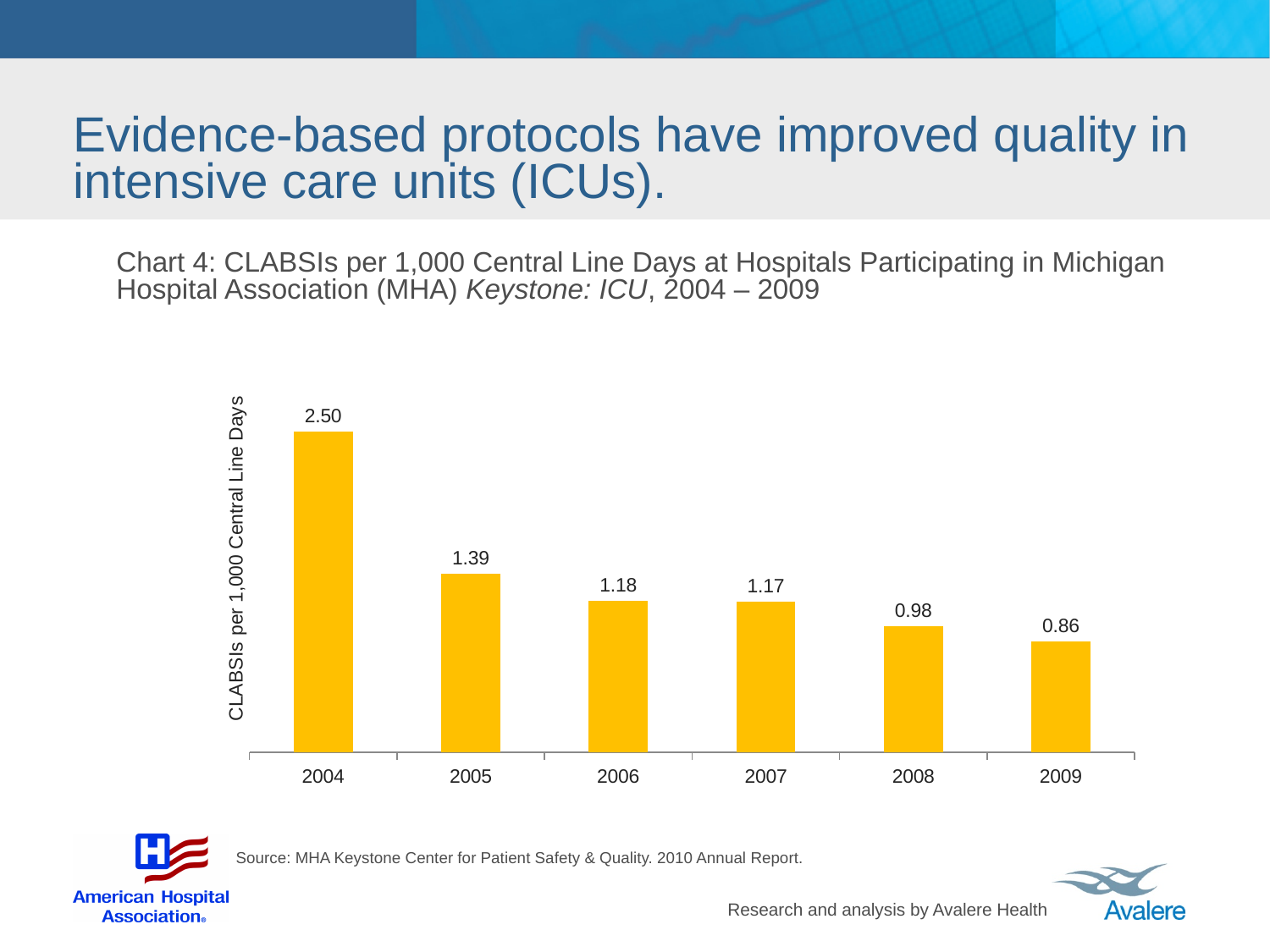
What is the difference between the values for 2008 and 2009? 0.12 Which year has the highest CLABSIs per 1,000 central line days? 2004 What is the difference between the values for 2004 and 2005? 1.11 Do the values rise or fall from 2004 to 2009? Fall What is the value for 2004? 2.50 What is the y-axis label of the chart? CLABSIs per 1,000 Central Line Days Which is larger, the value for 2005 or the value for 2008? 2005 What kind of chart is this? Bar chart What is the value for 2007? 1.17 How many years are shown on the x axis? 6 Which year has the lowest CLABSIs per 1,000 central line days? 2009 What is the value for 2009? 0.86